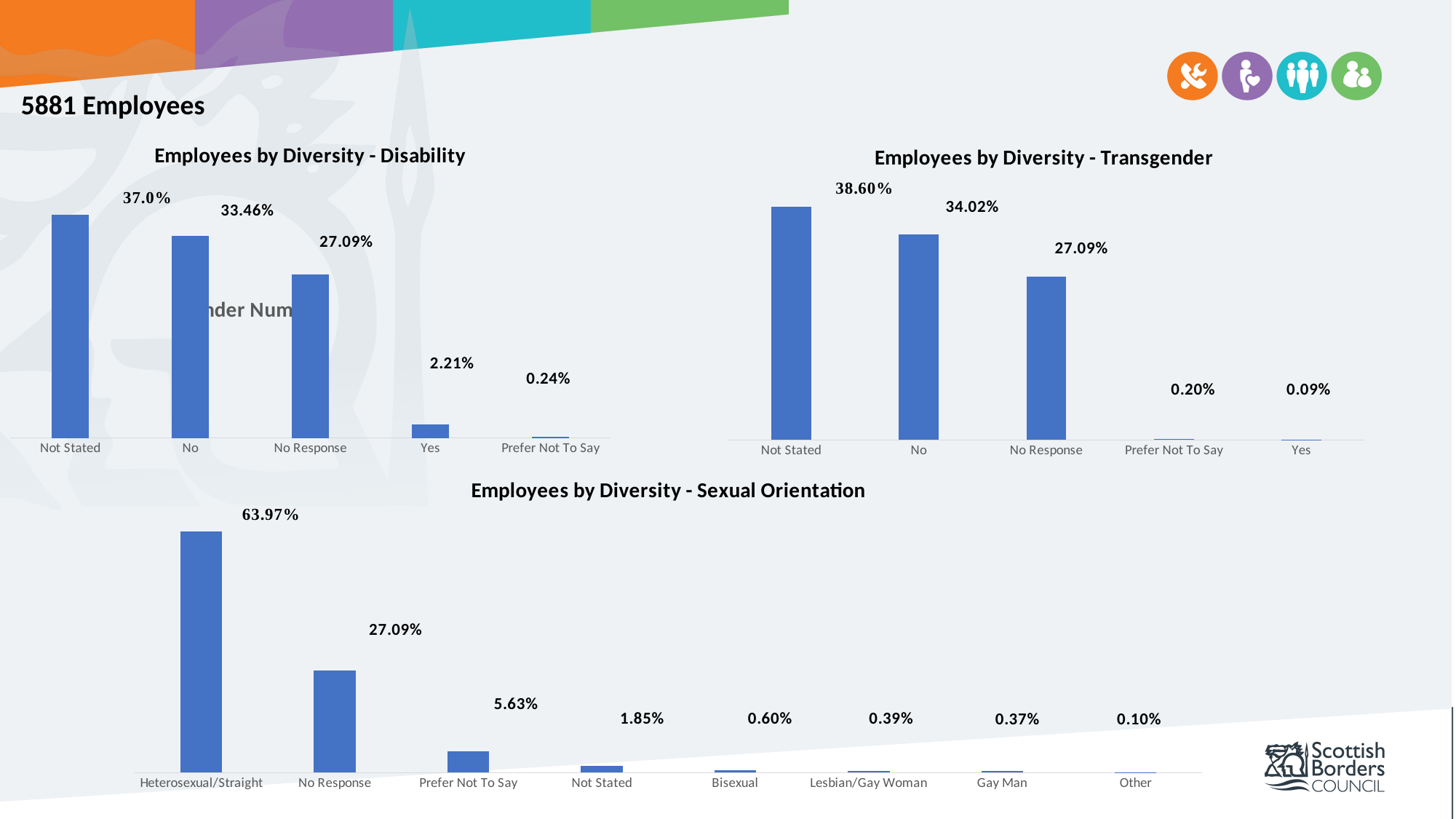
In the 'Employees by Diversity - Transgender' chart, what is the value for No? 34.02% In the 'Employees by Diversity - Sexual Orientation' chart, what is the value for Prefer Not To Say? 5.63% In the 'Employees by Diversity - Disability' chart, what is the value for Yes? 2.21% In the 'Employees by Diversity - Transgender' chart, how many categories are shown? 5 In the 'Employees by Diversity - Transgender' chart, which category has the lowest value? Yes In the 'Employees by Diversity - Sexual Orientation' chart, which is larger, the value for Bisexual or the value for Gay Man? Bisexual In the 'Employees by Diversity - Sexual Orientation' chart, how many categories are shown? 8 In the 'Employees by Diversity - Sexual Orientation' chart, what is the difference between the values for Heterosexual/Straight and No Response? 36.88% In the 'Employees by Diversity - Disability' chart, what is the difference between the values for Not Stated and No? 3.54% In the 'Employees by Diversity - Sexual Orientation' chart, which category has the highest value? Heterosexual/Straight In the 'Employees by Diversity - Disability' chart, which category has the highest value? Not Stated What kind of chart is 'Employees by Diversity - Transgender'? Bar chart